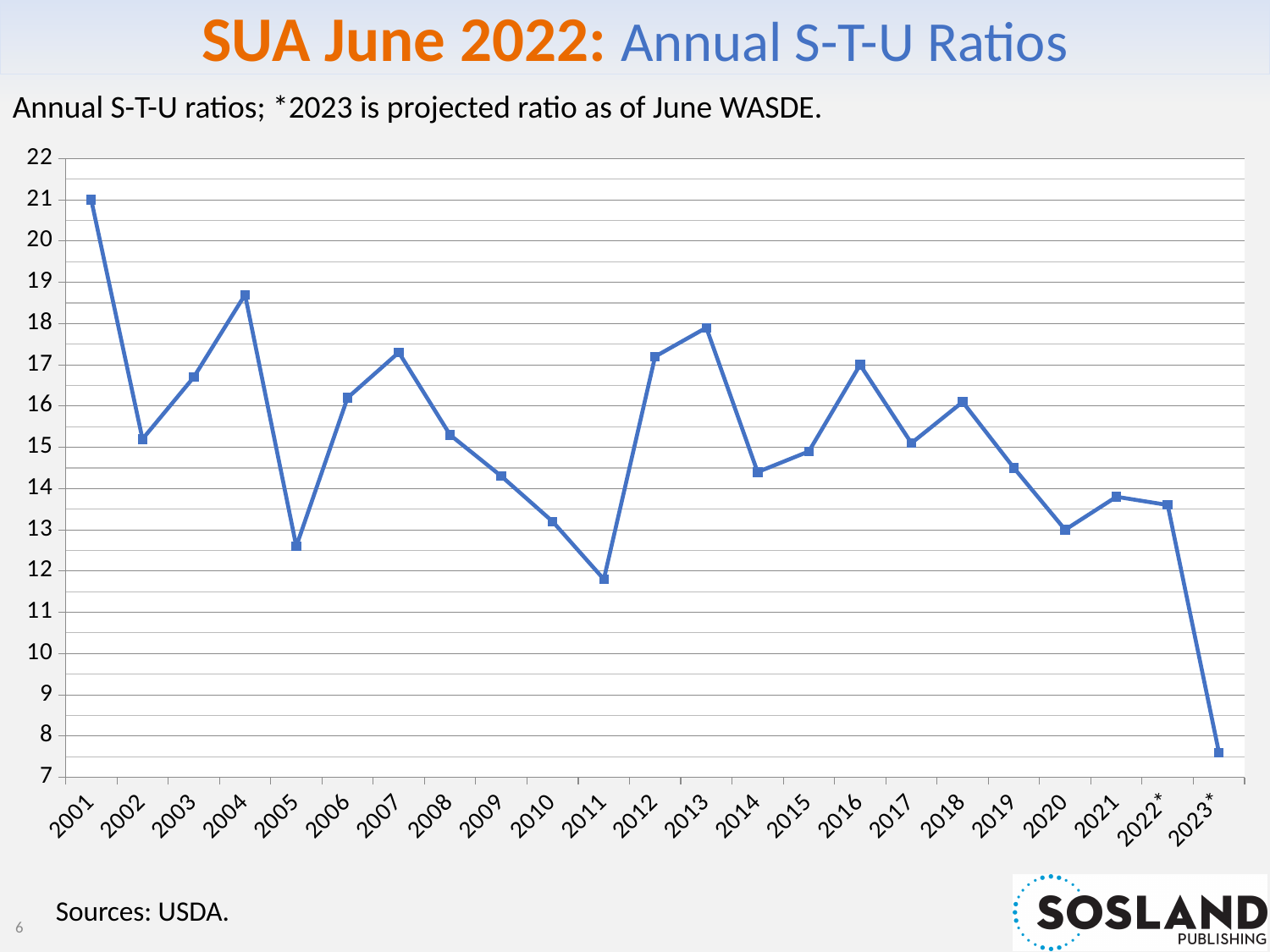
Is the value for 2013 greater or less than 17? greater Is the value for 2005 greater or less than 13? less How many years are plotted on the x axis? 23 Which year has the lowest S-T-U ratio? 2023* Which year has the larger S-T-U ratio, 2011 or 2012? 2012 Is the value for 2011 greater or less than 12? less Which year has the larger S-T-U ratio, 2004 or 2005? 2004 What kind of chart is shown on the slide? line chart Which year has the highest S-T-U ratio? 2001 Overall, do the S-T-U ratios rise or fall from 2001 to 2023*? fall